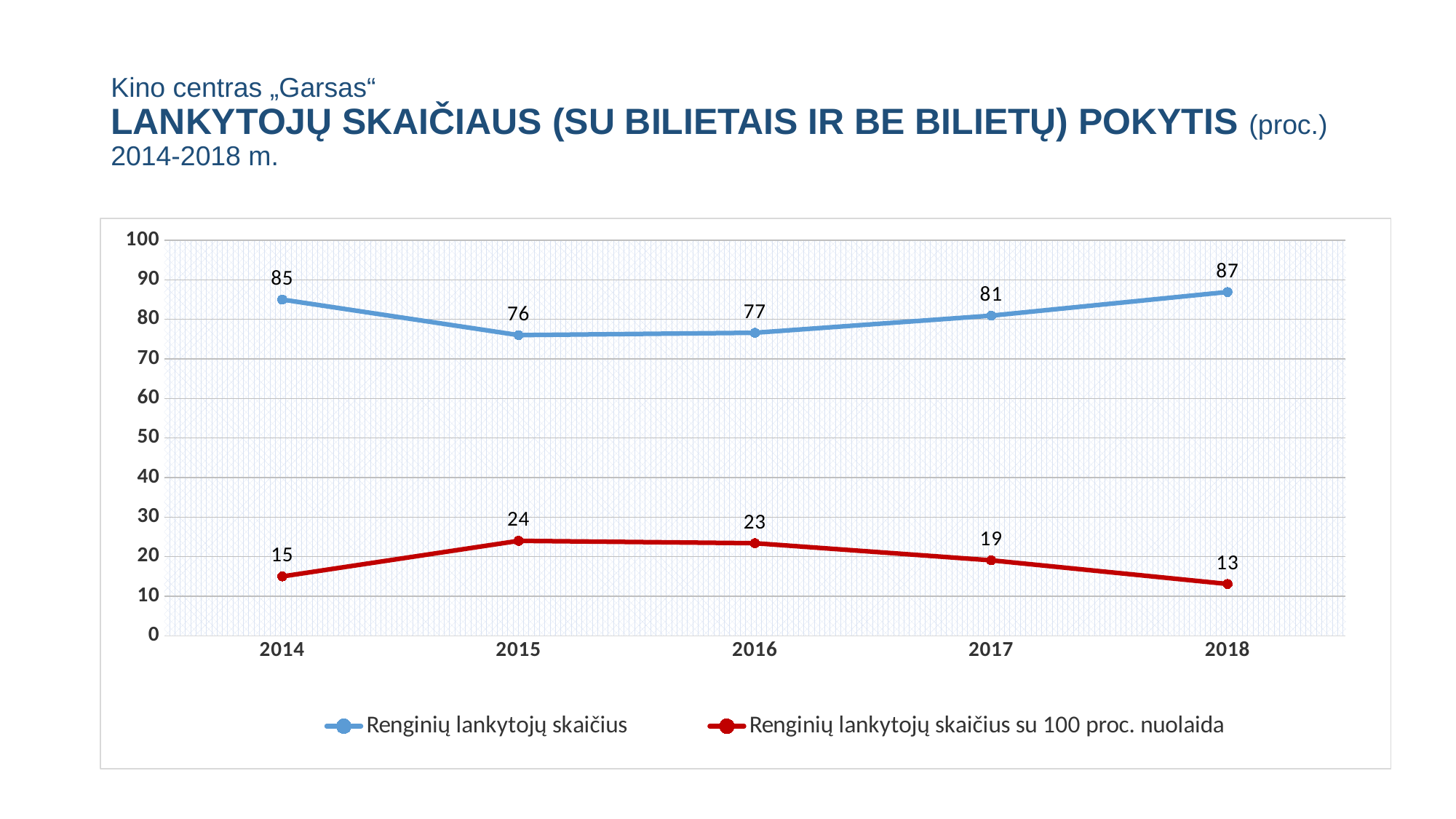
Does "Renginių lankytojų skaičius su 100 proc. nuolaida" rise or fall from 2015 to 2018? fall In which year is "Renginių lankytojų skaičius" highest? 2018 Is the value for "Renginių lankytojų skaičius" in 2016 greater or less than 70? greater How many years are shown on the x axis? 5 What kind of chart is shown on the slide? line chart How many series does the legend list? 2 Which is larger: the "Renginių lankytojų skaičius su 100 proc. nuolaida" value in 2015 or in 2014? 2015 What is the difference between the "Renginių lankytojų skaičius" values for 2018 and 2015? 11 What is the value for "Renginių lankytojų skaičius su 100 proc. nuolaida" in 2017? 19 What is the value for "Renginių lankytojų skaičius" in 2014? 85 In which year is "Renginių lankytojų skaičius su 100 proc. nuolaida" lowest? 2018 What colour is the line for "Renginių lankytojų skaičius su 100 proc. nuolaida"? red